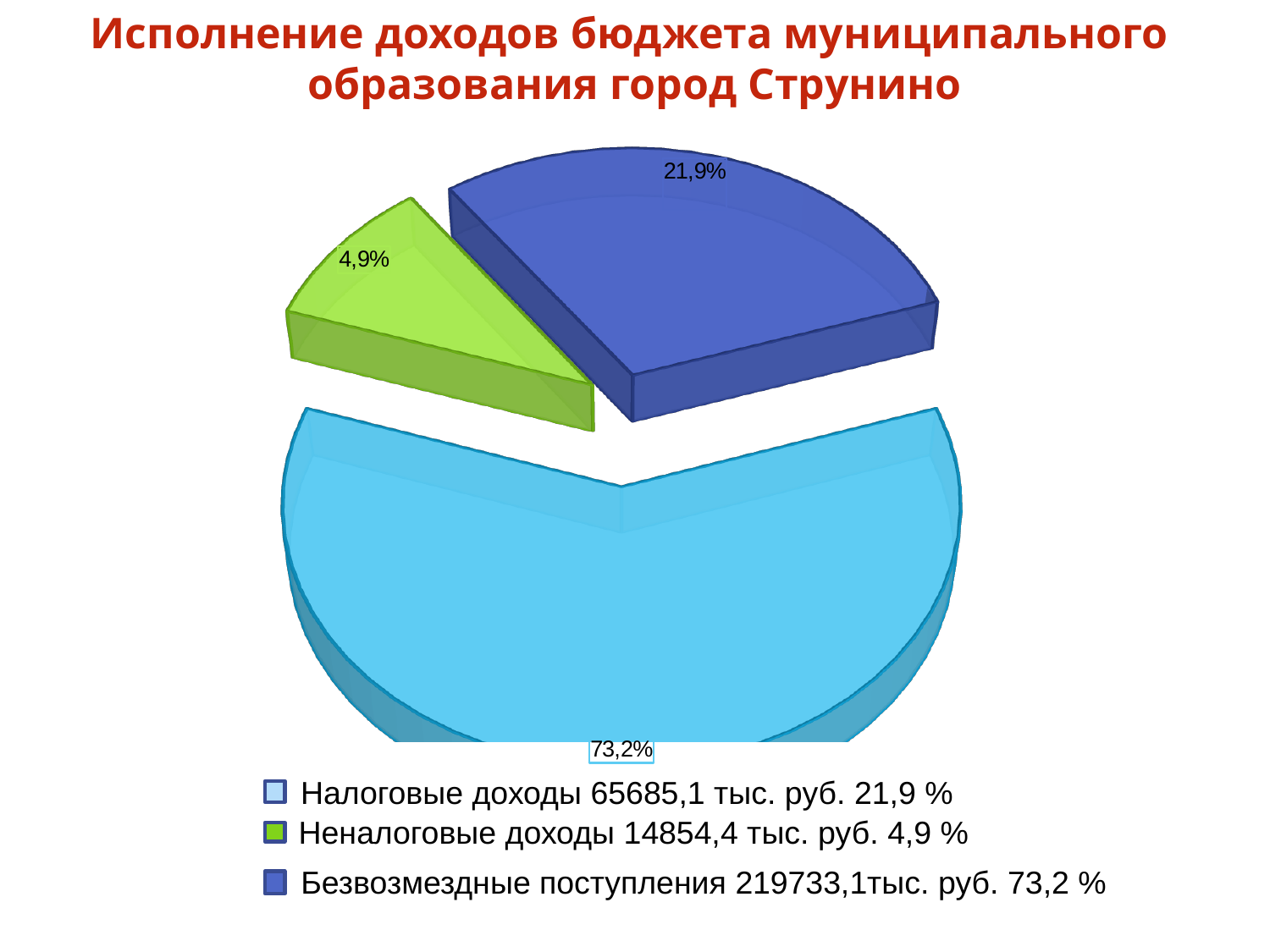
Which is larger: the share for Налоговые доходы or the share for Неналоговые доходы? Налоговые доходы According to the legend, what amount in тыс. руб. corresponds to Налоговые доходы? 65685,1 тыс. руб. What is the title of the slide? Исполнение доходов бюджета муниципального образования город Струнино What share of the pie does Безвозмездные поступления take? 73,2% Which category has the largest slice of the pie? Безвозмездные поступления What share of the pie does Налоговые доходы take? 21,9% What share of the pie does Неналоговые доходы take? 4,9% What kind of chart is shown on the slide? pie chart How many slices does the pie chart have? 3 According to the legend, what amount in тыс. руб. corresponds to Безвозмездные поступления? 219733,1 тыс. руб. Which category has the smallest slice of the pie? Неналоговые доходы By how many percentage points does the share of Безвозмездные поступления exceed the share of Налоговые доходы? 51,3